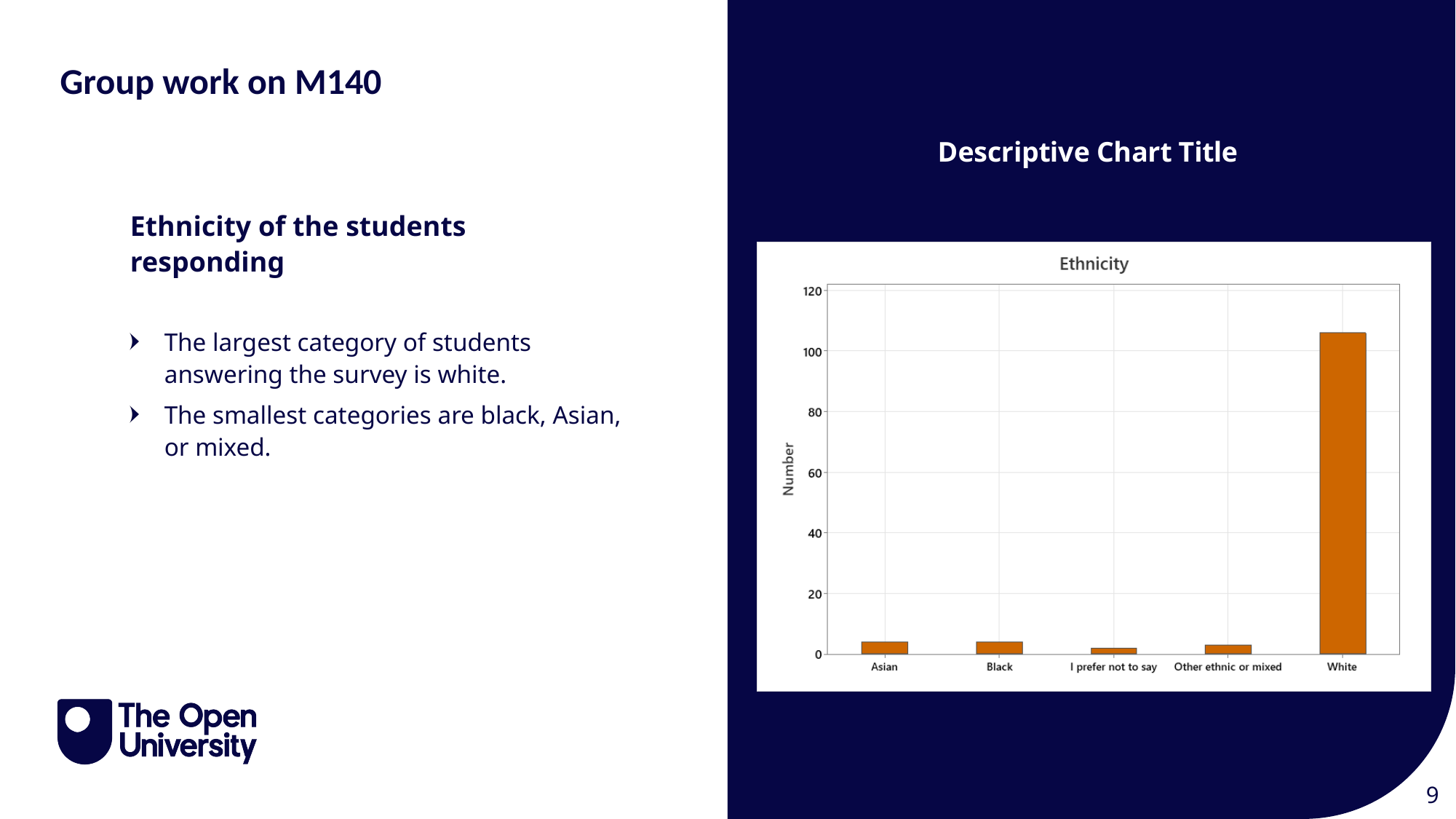
What is the title of the chart? Ethnicity Is the value for White greater or less than 100? greater Is the value for Asian greater or less than 20? less Which is larger, the value for White or the value for Asian? White What is the label on the y axis of the chart? Number How many categories are shown on the x axis of the Ethnicity chart? 5 Is the value for Other ethnic or mixed greater or less than 20? less What kind of chart is shown on the slide? bar chart Which is larger, the value for Black or the value for White? White Which category has the highest value in the Ethnicity chart? White